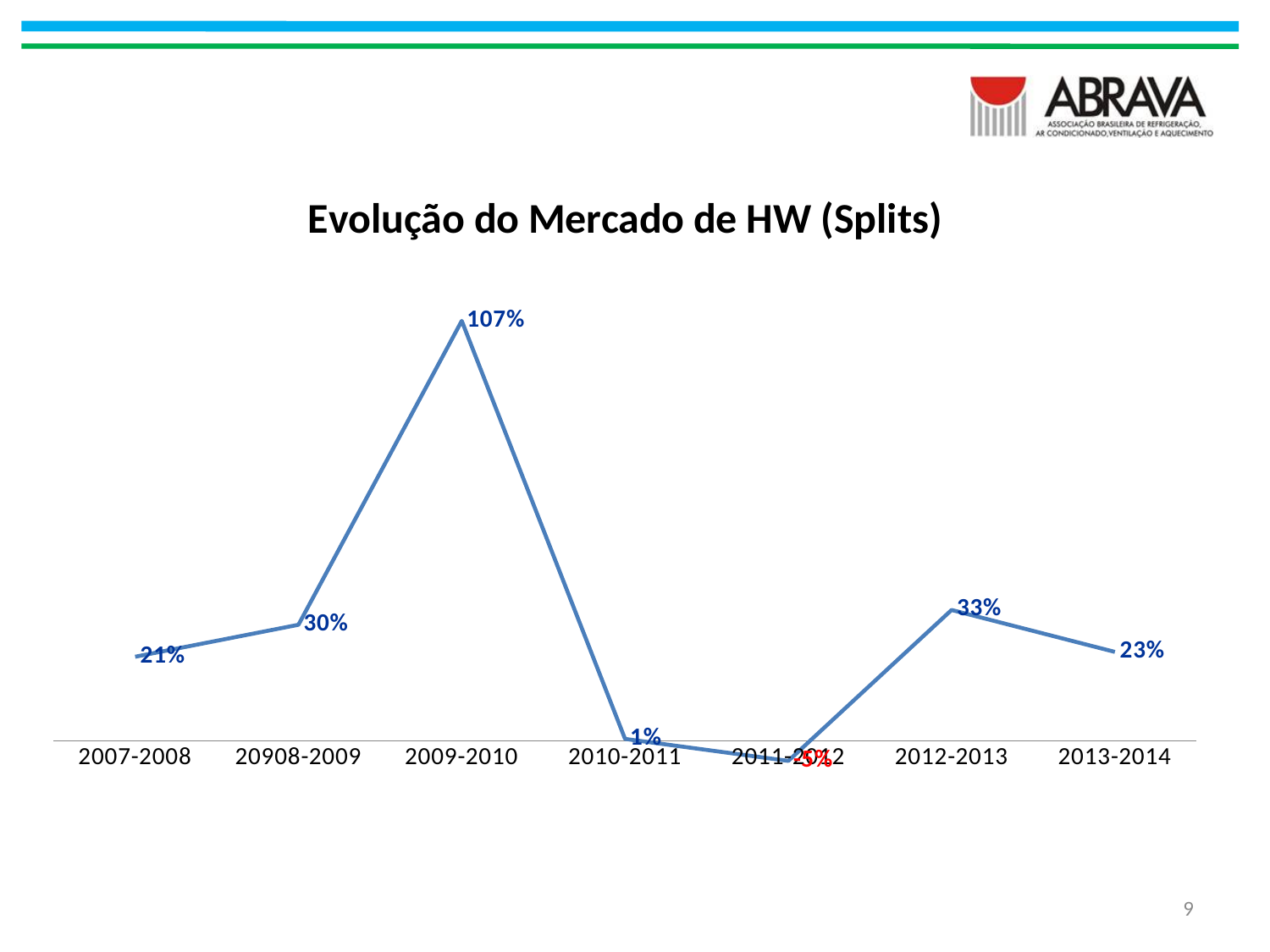
What is the value for 2012-2013? 33% What is the value for 2013-2014? 23% Which period has the highest value? 2009-2010 How many periods are plotted on the chart? 7 Which period has the lowest value? 2011-2012 What kind of chart is shown on the slide? Line chart What is the difference between the values for 2012-2013 and 2013-2014? 10 percentage points What is the difference between the values for 2009-2010 and 20908-2009? 77 percentage points What is the value for 2009-2010? 107% Which is larger, the value for 2012-2013 or the value for 2013-2014? 2012-2013 What is the value for 2007-2008? 21% What is the value for 2010-2011? 1%